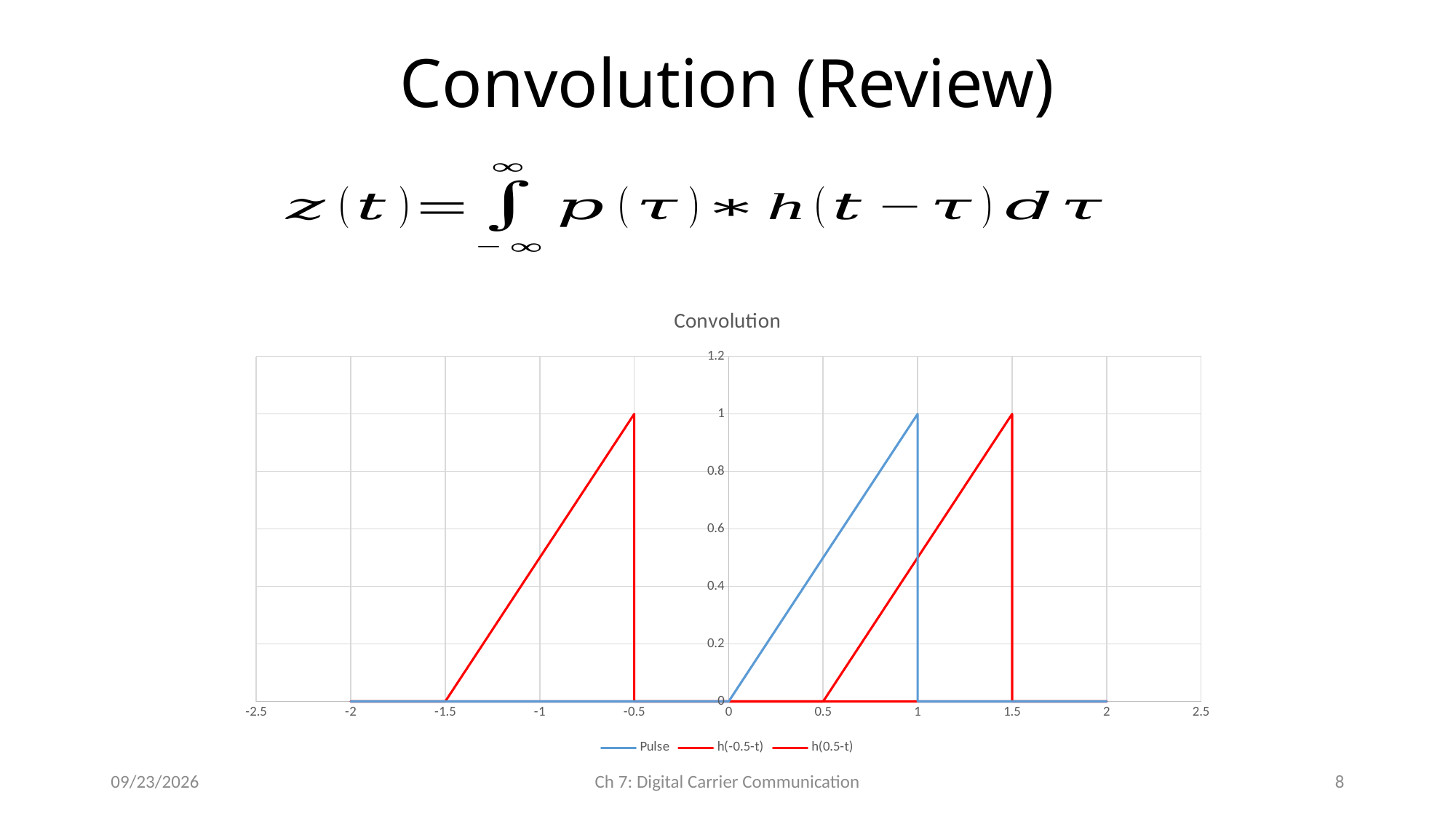
Is the value of the Pulse series at x = 0.5 greater or less than 0.2? greater At what x value does the Pulse series reach its peak? 1 What is the title of the chart? Convolution What is the peak value reached by the Pulse series? 1 What type of chart is shown on the slide? line chart At what x value does the leftmost red triangle reach its peak? -0.5 At what x value does the rightmost red triangle reach its peak? 1.5 At x = 0.75, which is higher: the Pulse series or the rightmost red triangle? Pulse Between x = 0 and x = 1, does the Pulse series rise or fall? rise Is the value of the rightmost red triangle at x = 1 greater or less than 0.8? less How many series does the legend of the chart list? 3 Which series in the legend is drawn in blue? Pulse